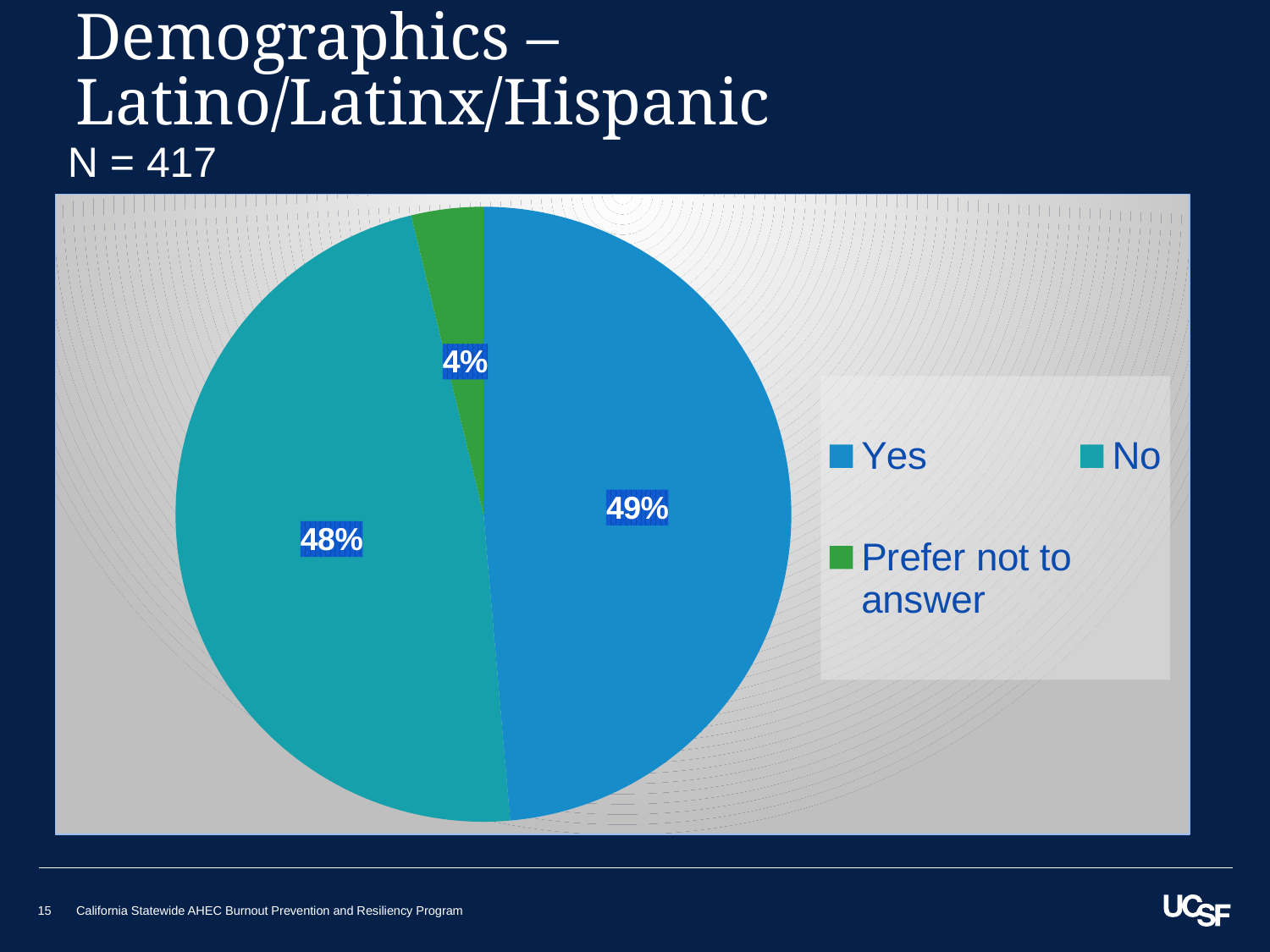
What percentage of respondents answered No? 48% What percentage of respondents answered Yes? 49% What is the difference in percentage points between the No slice and the Prefer not to answer slice? 44% Is the share for Yes larger than the share for Prefer not to answer? Yes How many categories are shown in the pie chart? 3 What is the sample size (N) stated on the slide? 417 What percentage of respondents chose Prefer not to answer? 4% What is the difference in percentage points between the Yes and No slices? 1% What kind of chart is shown on the slide? Pie chart Which category has the smallest share of the pie? Prefer not to answer Which colour represents the Prefer not to answer category? Green